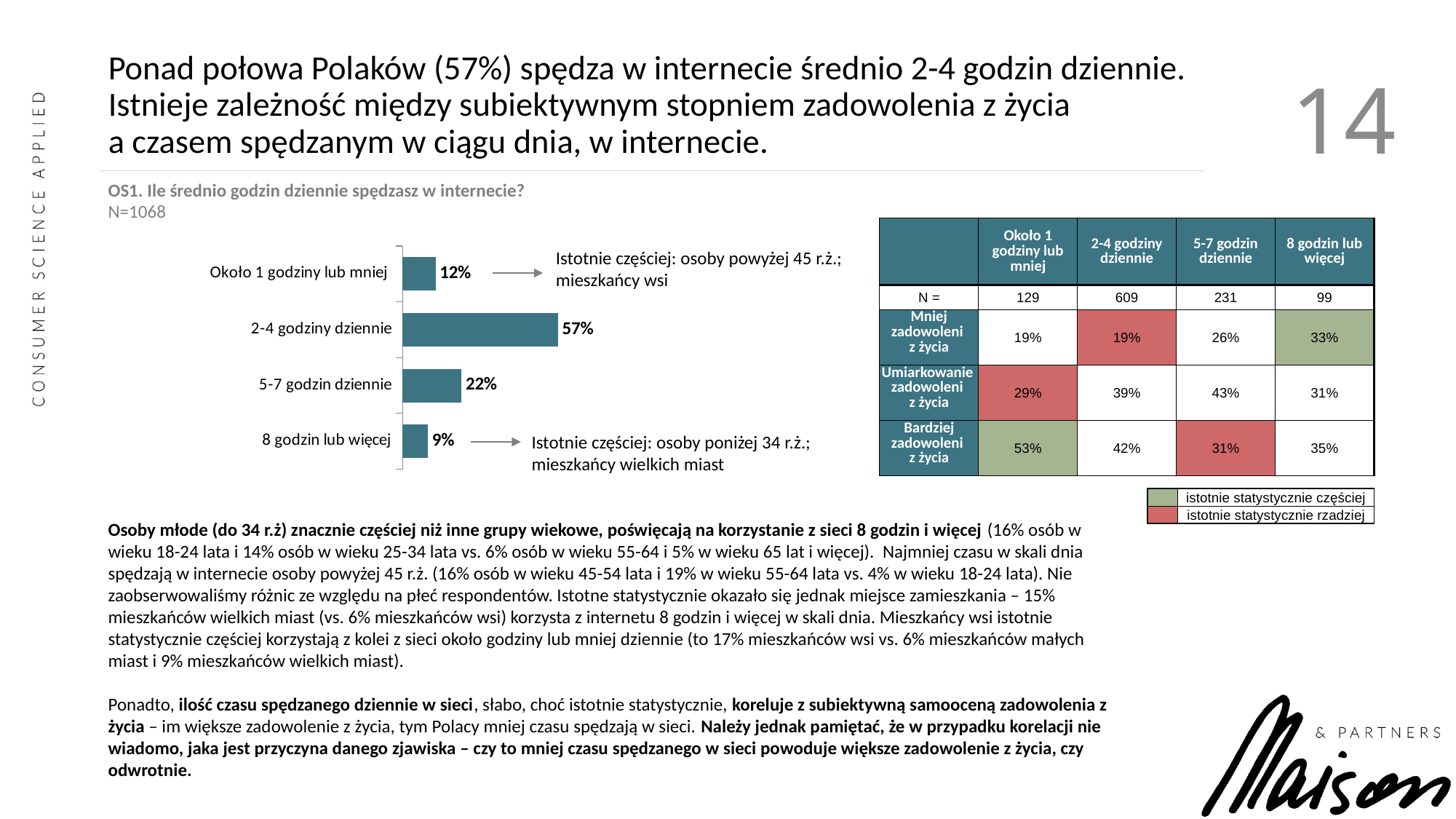
Which is larger: the value for 'Około 1 godziny lub mniej' or the value for '8 godzin lub więcej'? Około 1 godziny lub mniej How many categories are shown in the bar chart? 4 What is the sample size (N) stated for the bar chart? N=1068 What type of chart is used to show the daily internet usage time? Bar chart What survey question (OS1) does the bar chart present? Ile średnio godzin dziennie spędzasz w internecie? Which category has the lowest value in the bar chart? 8 godzin lub więcej What percentage of respondents spend 2-4 hours a day on the internet (2-4 godziny dziennie)? 57% What is the difference in percentage points between '2-4 godziny dziennie' and '5-7 godzin dziennie'? 35 percentage points What is the value shown for '5-7 godzin dziennie'? 22% What is the value shown for '8 godzin lub więcej'? 9% Which category has the highest value in the bar chart? 2-4 godziny dziennie What is the value shown for 'Około 1 godziny lub mniej'? 12%